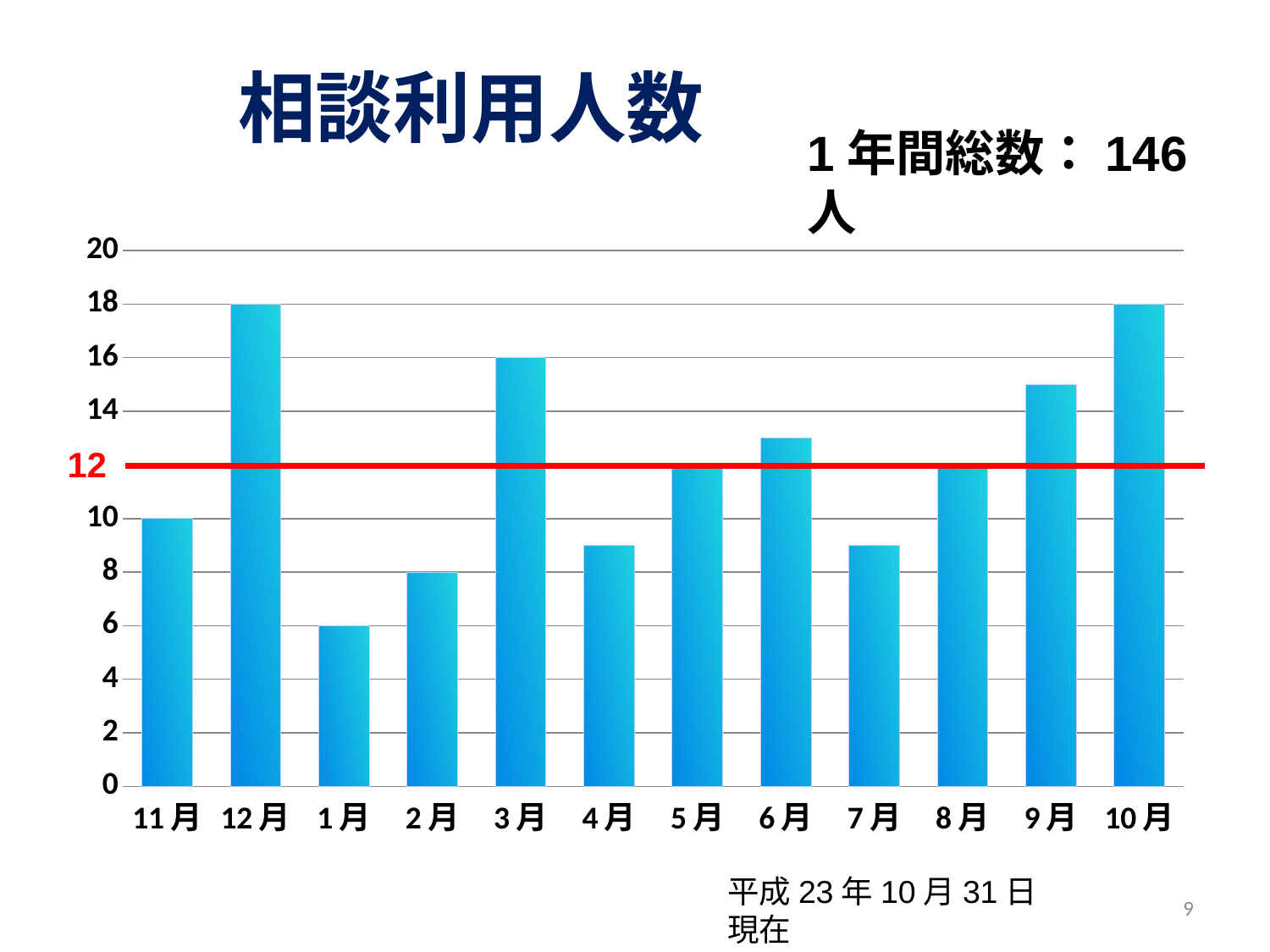
Is the value for 4月 greater or less than 10? less How many months are plotted on the x axis? 12 What is the difference between the values for 12月 and 1月? 12 Which month has the lowest value? 1月 Which is larger, the value for 3月 or the value for 11月? 3月 What is the value for 3月? 16 What is the title of the chart? 相談利用人数 At what value is the red horizontal line drawn across the chart? 12 What is the value for 12月? 18 What kind of chart is shown on the slide? bar chart What is the value for 11月? 10 What is the value for 1月? 6